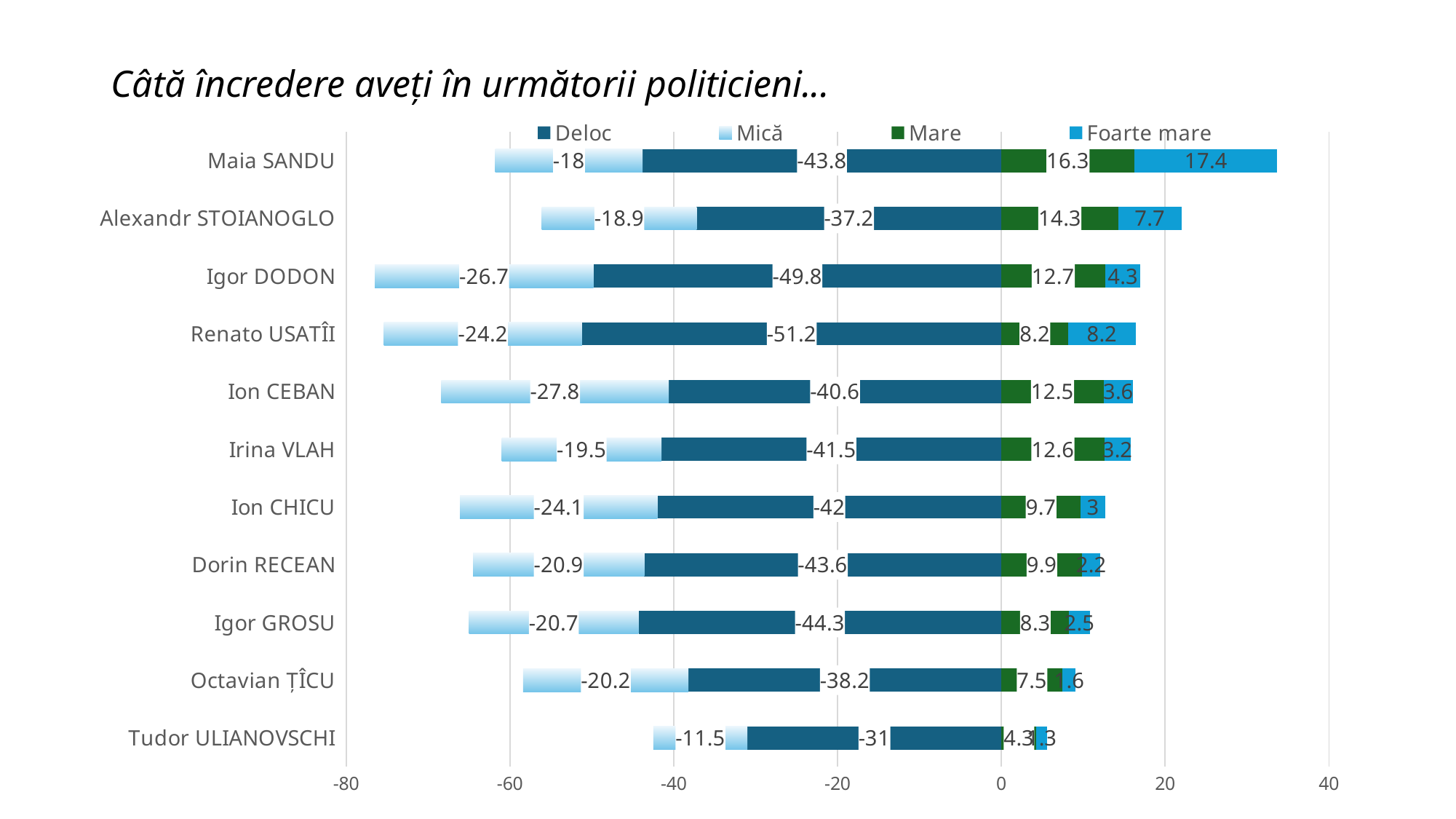
Which is larger, the 'Foarte mare' value for Alexandr STOIANOGLO or for Igor DODON? Alexandr STOIANOGLO How many politicians are listed on the chart? 11 What is the 'Mică' value for Ion CEBAN? -27.8 What is the difference between the 'Mare' values for Maia SANDU and Igor DODON? 3.6 How many series does the legend list? 4 What kind of chart is shown on the slide? Stacked bar chart Which politician has the highest 'Foarte mare' value? Maia SANDU Which politician has the lowest 'Deloc' value (the most negative)? Renato USATÎI What is the 'Foarte mare' value for Maia SANDU? 17.4 What is the title of the chart? Câtă încredere aveți în următorii politicieni... What is the 'Mare' value for Alexandr STOIANOGLO? 14.3 What is the 'Deloc' value for Igor DODON? -49.8